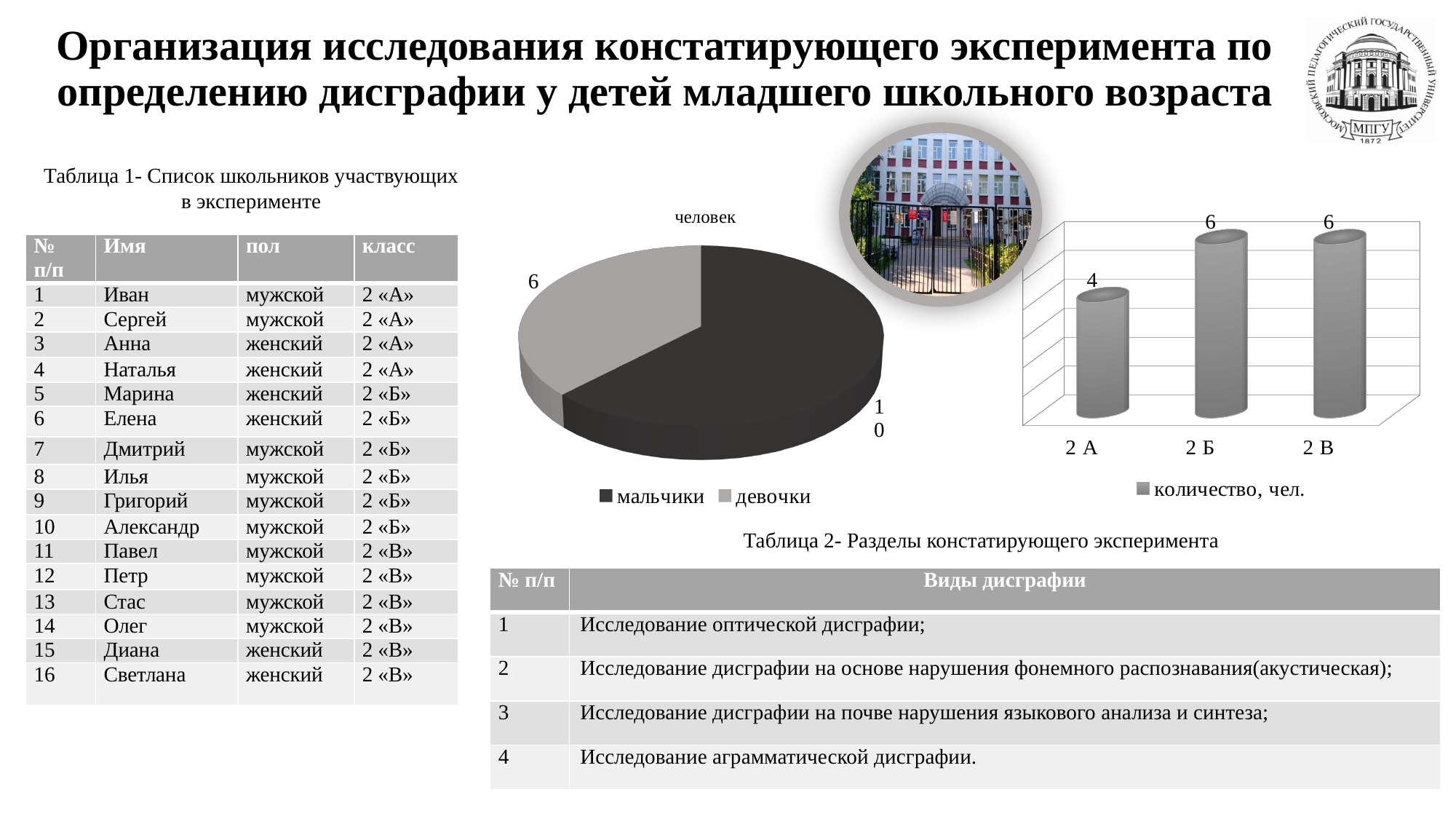
In the pie chart titled "человек", what is the value for девочки? 6 In the pie chart titled "человек", how many slices are there? 2 In the bar chart on the right, which category has the lowest value? 2 А What type of chart is the chart titled "человек"? pie chart In the bar chart on the right, what is the difference between the values for 2 В and 2 А? 2 In the pie chart titled "человек", what is the difference between the values for мальчики and девочки? 4 In the bar chart on the right, what is the value for 2 Б? 6 In the bar chart on the right, how many categories are shown? 3 In the pie chart titled "человек", which slice is larger, мальчики or девочки? мальчики In the pie chart titled "человек", what is the value for мальчики? 10 In the bar chart on the right, what series name does the legend show? количество, чел. In the bar chart on the right, what is the value for 2 А? 4